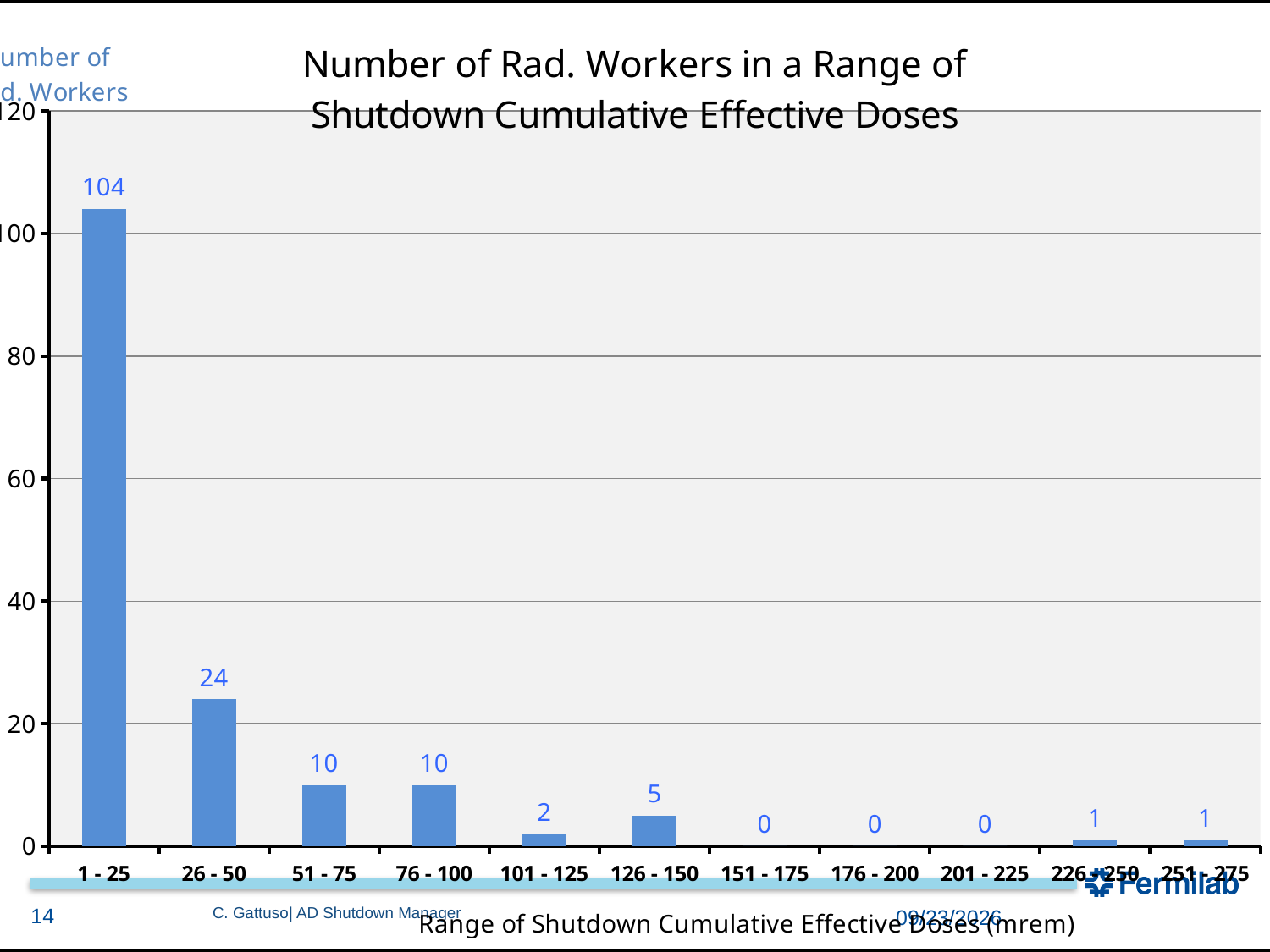
How many dose ranges have 0 rad. workers? 3 What is the difference between the number of rad. workers in the 126 - 150 range and the 101 - 125 range? 3 What is the number of rad. workers in the 226 - 250 mrem dose range? 1 Which dose range has the highest number of rad. workers? 1 - 25 What is the number of rad. workers in the 1 - 25 mrem dose range? 104 How many dose range categories are shown on the x axis? 11 What is the number of rad. workers in the 26 - 50 mrem dose range? 24 What is the title of the chart? Number of Rad. Workers in a Range of Shutdown Cumulative Effective Doses What is the number of rad. workers in the 126 - 150 mrem dose range? 5 Which has more rad. workers, the 101 - 125 range or the 126 - 150 range? 126 - 150 What type of chart is shown on the slide? Bar chart What is the difference between the number of rad. workers in the 1 - 25 range and the 26 - 50 range? 80